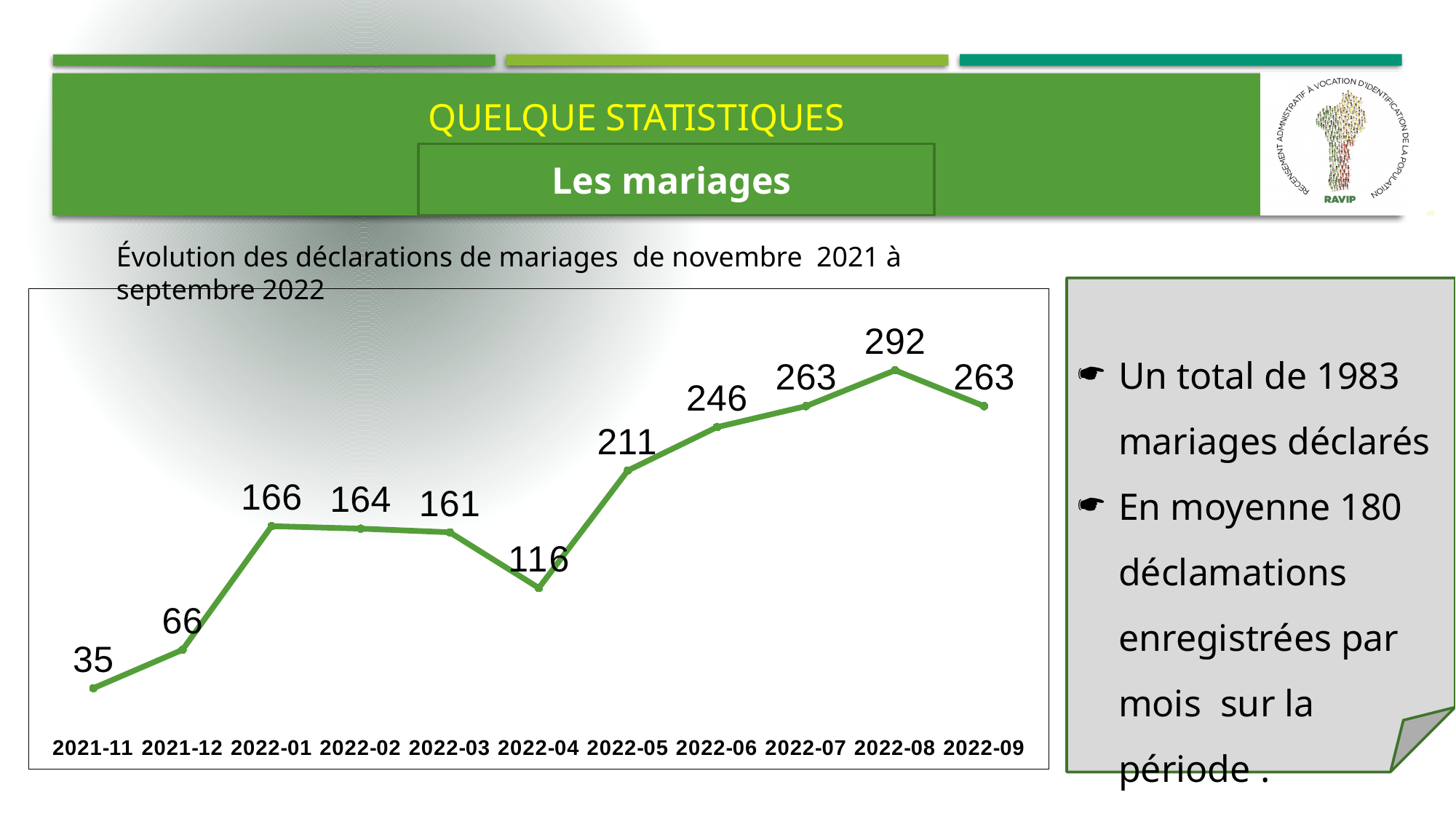
What is the difference between the values for 2022-01 and 2021-12? 100 Which month has the lowest value? 2021-11 Which is larger, the value for 2022-03 or the value for 2022-04? 2022-03 How many marriage declarations were recorded in 2022-04? 116 What is the difference between the values for 2022-08 and 2022-09? 29 What type of chart is shown on the slide? line chart How many months are plotted on the chart? 11 What is the title of the chart? Évolution des déclarations de mariages de novembre 2021 à septembre 2022 Which month has the highest value? 2022-08 What is the value for 2022-05? 211 Do the values rise or fall from 2021-11 to 2022-01? rise What is the value for 2021-11? 35